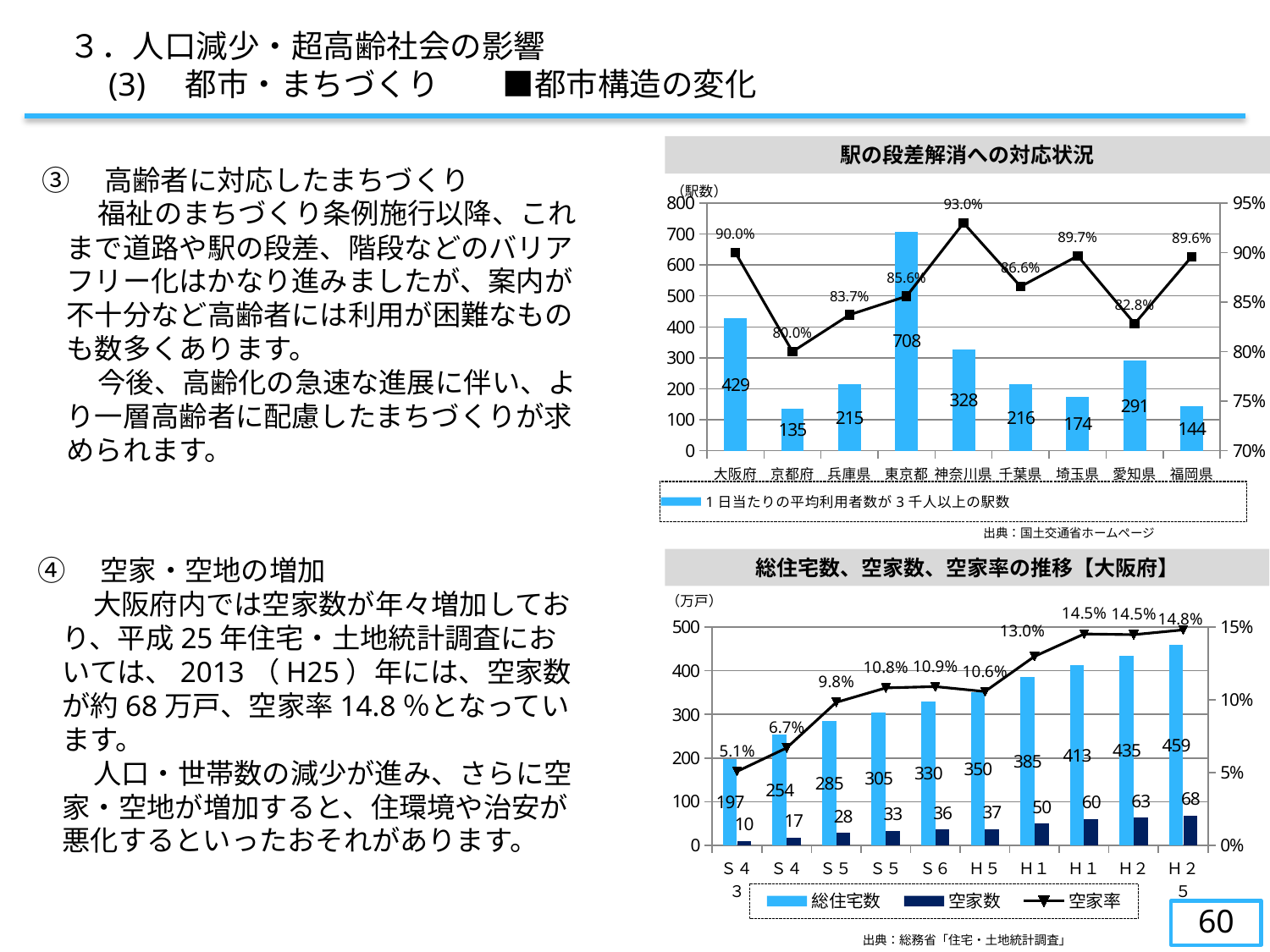
In the chart titled 総住宅数、空家数、空家率の推移【大阪府】, what is the value of 空家数 for H25? 68 In the chart titled 駅の段差解消への対応状況, what percentage is shown for 神奈川県 on the line? 93.0% In the chart titled 駅の段差解消への対応状況, what is the number of stations for 東京都? 708 In the chart titled 総住宅数、空家数、空家率の推移【大阪府】, how many series does the legend list? 3 In the chart titled 駅の段差解消への対応状況, how many prefectures are shown on the x axis? 9 In the chart titled 駅の段差解消への対応状況, which prefecture has the highest number of stations? 東京都 In the chart titled 駅の段差解消への対応状況, what is the difference between the number of stations for 大阪府 and 神奈川県? 101 In the chart titled 総住宅数、空家数、空家率の推移【大阪府】, what is the 空家率 for H25? 14.8% In the chart titled 総住宅数、空家数、空家率の推移【大阪府】, does 総住宅数 rise or fall from left to right along the x axis? rise In the chart titled 駅の段差解消への対応状況, which prefecture has the lowest number of stations? 京都府